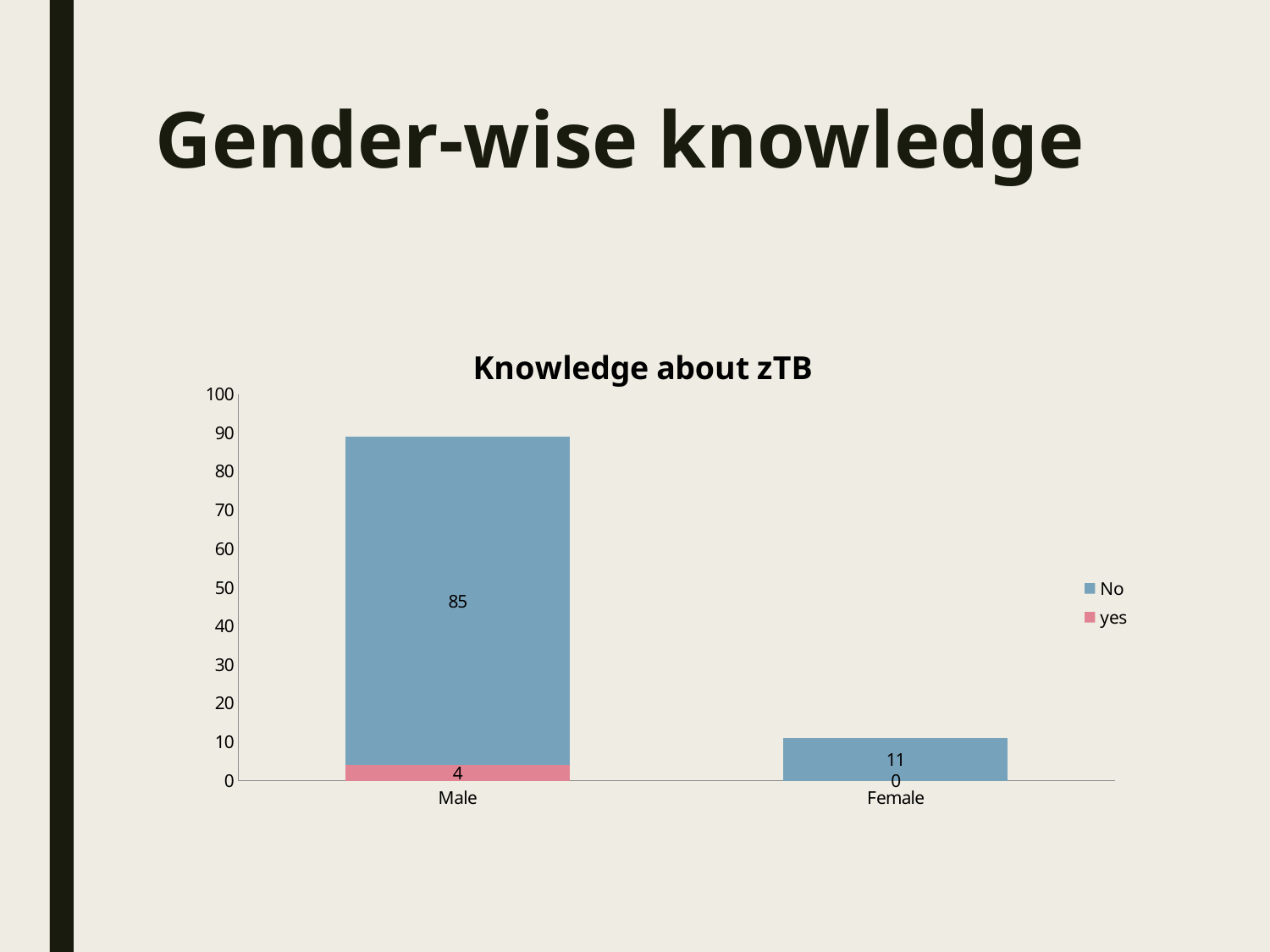
What is the value of the "yes" series for Male? 4 What is the total height of the stacked bar for Male? 89 Which category has the higher "No" value? Male What is the value of the "No" series for Male? 85 Is the "No" value for Male greater or less than 50? greater What is the difference between the "No" values for Male and Female? 74 What is the value of the "No" series for Female? 11 What is the total height of the stacked bar for Female? 11 How many categories are shown on the x axis? 2 What is the title of the chart? Knowledge about zTB What is the value of the "yes" series for Female? 0 How many series does the legend list? 2